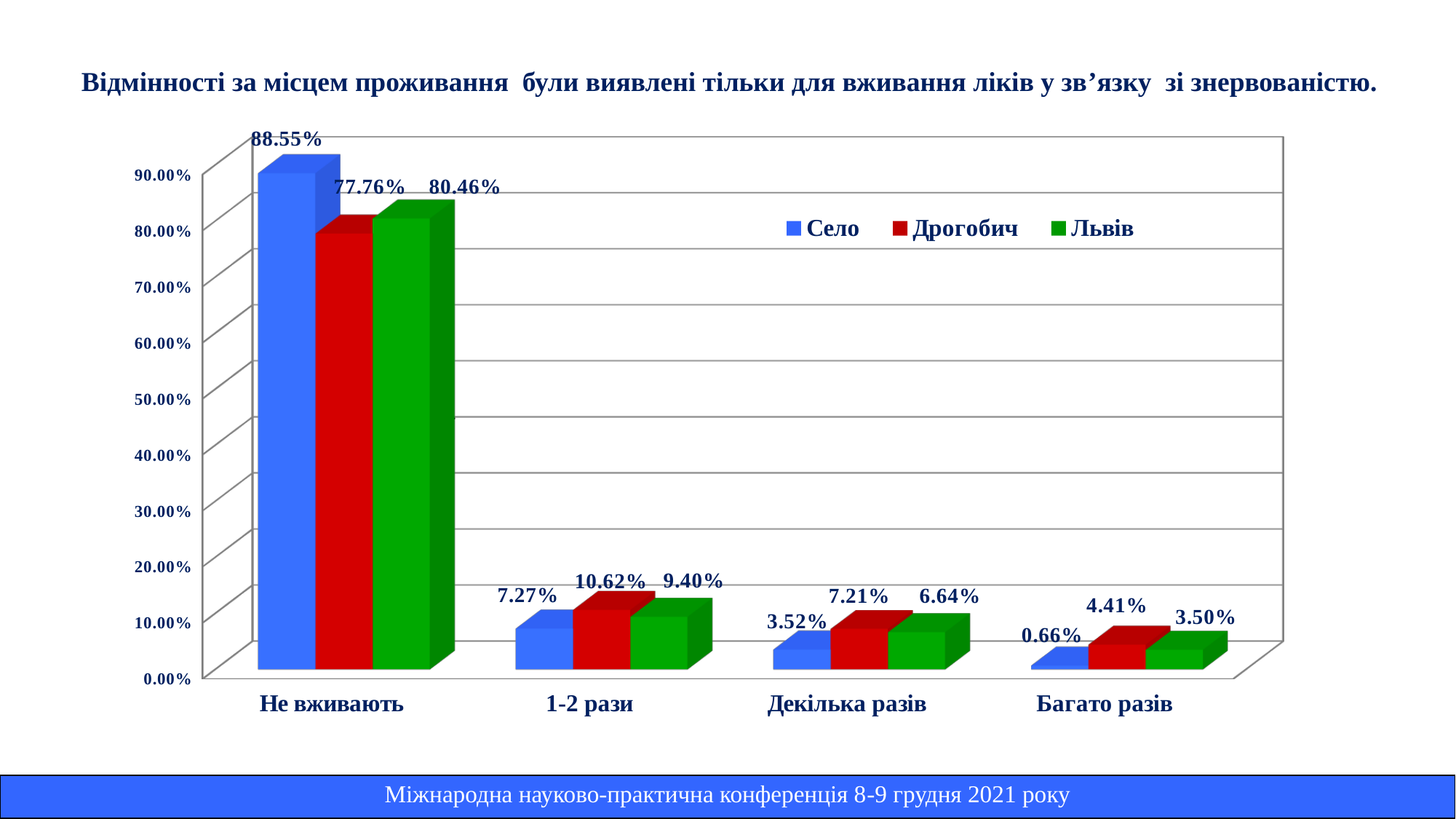
What kind of chart is shown on the slide? Bar chart What is the value for Село in the category Багато разів? 0.66% What is the value for Село in the category Не вживають? 88.55% How many categories are shown on the x axis? 4 What is the difference between the Село and Дрогобич values in the category Не вживають? 10.79% Which colour represents the series Львів in the legend? Green What is the value for Львів in the category Декілька разів? 6.64% How many series does the legend list? 3 Which series has the highest value in the category Не вживають? Село What is the value for Дрогобич in the category 1-2 рази? 10.62% Which is larger in the category 1-2 рази: the value for Дрогобич or the value for Львів? Дрогобич Which series has the lowest value in the category Багато разів? Село